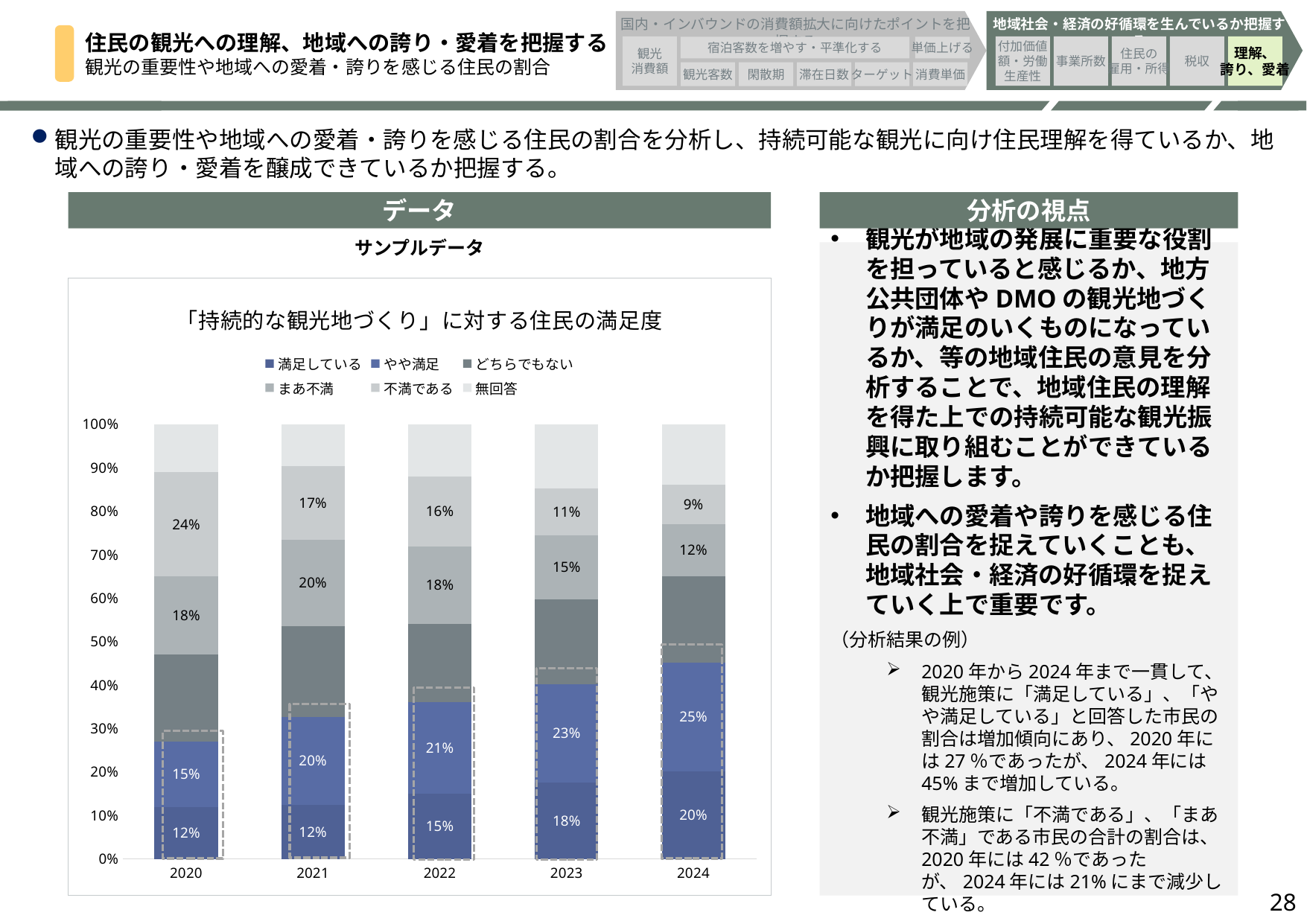
In which year is the value for やや満足 the highest? 2024 What is the value for 満足している in 2024? 20% How many series does the legend of the chart list? 6 In which year is the value for まあ不満 the lowest? 2024 How many years are shown on the x axis of the chart? 5 What is the value for まあ不満 in 2020? 18% What is the difference between the 満足している values for 2024 and 2020? 8% Does the value for 満足している rise or fall from 2020 to 2024? Rise What kind of chart is shown on the slide? Stacked bar chart What is the value for やや満足 in 2022? 21%